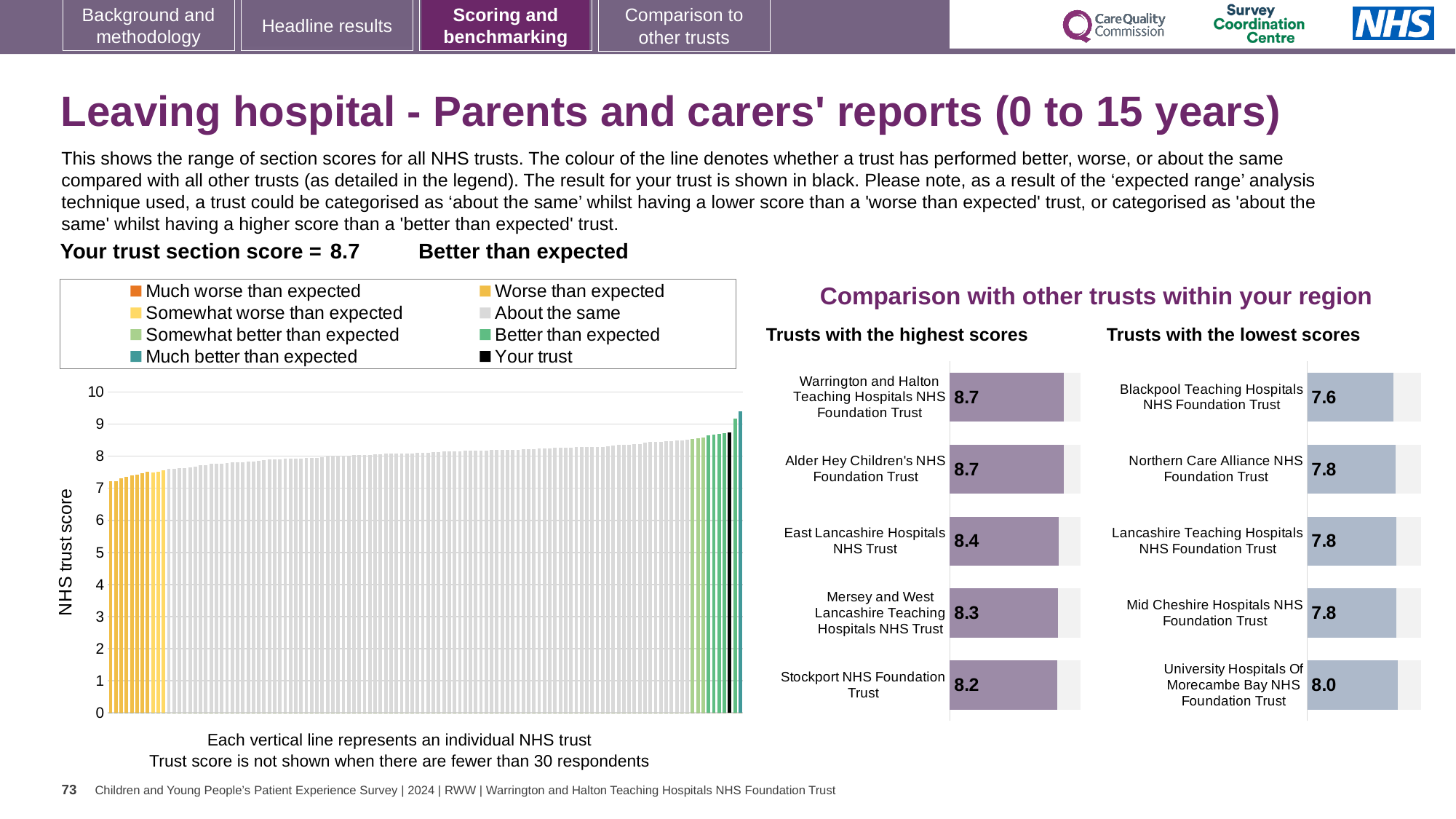
In the 'Trusts with the lowest scores' chart, what is the score for Blackpool Teaching Hospitals NHS Foundation Trust? 7.6 How many trusts are shown in the 'Trusts with the highest scores' chart? 5 In the 'Trusts with the highest scores' chart, what is the difference between the scores of Warrington and Halton Teaching Hospitals NHS Foundation Trust and Stockport NHS Foundation Trust? 0.5 What is the y-axis label of the main chart on the left? NHS trust score In the 'Trusts with the highest scores' chart, which has the higher score: Mersey and West Lancashire Teaching Hospitals NHS Trust or Stockport NHS Foundation Trust? Mersey and West Lancashire Teaching Hospitals NHS Trust In the main chart on the left, is the value of the tallest bar greater or less than 9? greater What kind of chart is the main chart on the left of the slide? Bar chart In the 'Trusts with the lowest scores' chart, which trust has the highest score? University Hospitals Of Morecambe Bay NHS Foundation Trust How many trusts are shown in the 'Trusts with the lowest scores' chart? 5 In the 'Trusts with the lowest scores' chart, which trust has the lowest score? Blackpool Teaching Hospitals NHS Foundation Trust How many entries does the legend of the main chart on the left list? 8 In the 'Trusts with the highest scores' chart, what is the score for East Lancashire Hospitals NHS Trust? 8.4